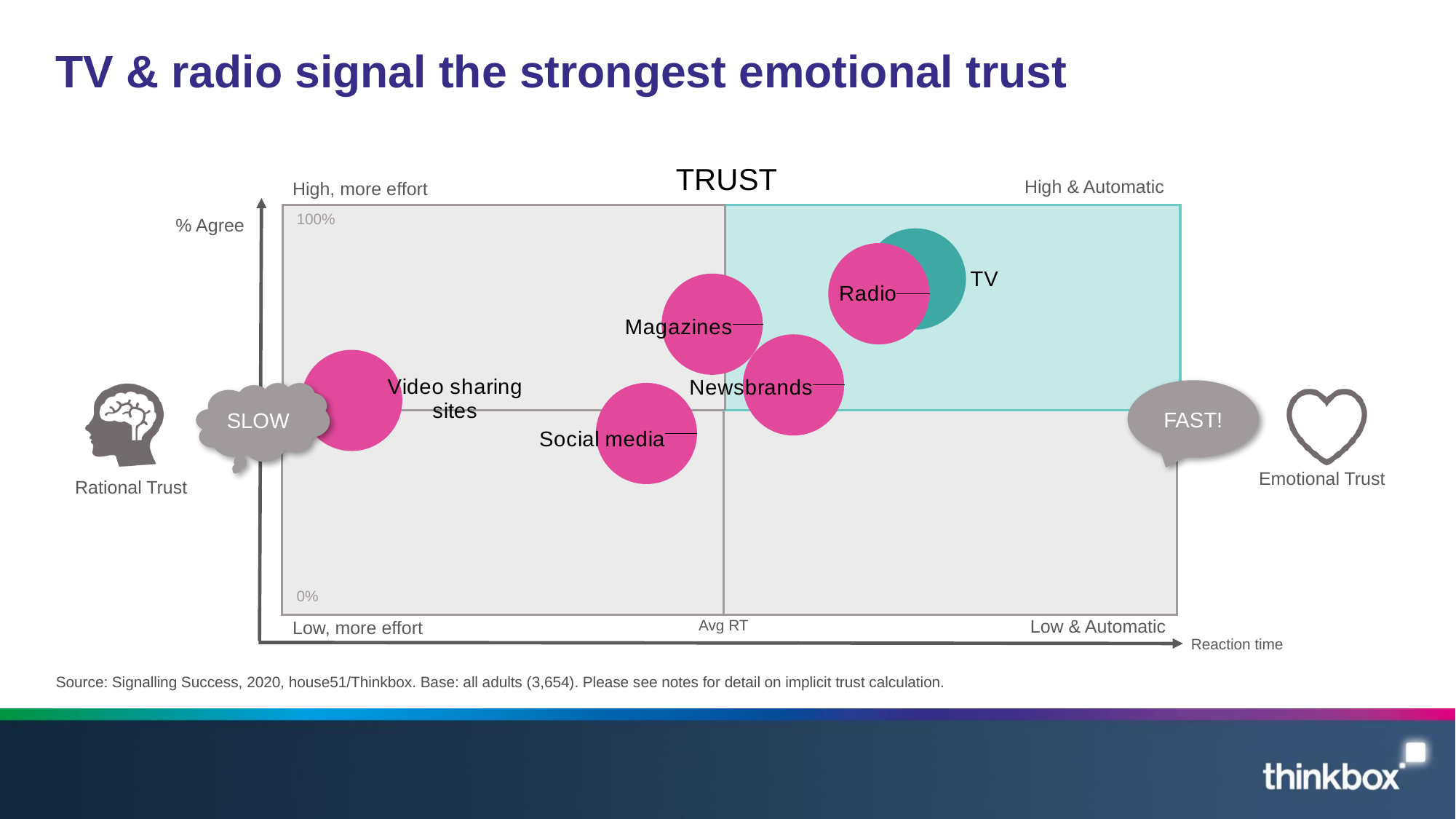
Which has a higher % Agree, Magazines or Social media? Magazines Which category has the highest % Agree on the chart? TV Which category is plotted furthest to the right (fastest reaction time)? TV Which has a higher % Agree, Newsbrands or Video sharing sites? Newsbrands Which category is plotted in a teal bubble rather than pink? TV Which category is plotted furthest to the left (slowest reaction time)? Video sharing sites What is the label of the vertical axis? % Agree How many media categories are plotted as bubbles on the chart? 6 What is the label of the horizontal axis? Reaction time Which category has the lowest % Agree on the chart? Social media What kind of chart is shown on the slide? Bubble (scatter) chart